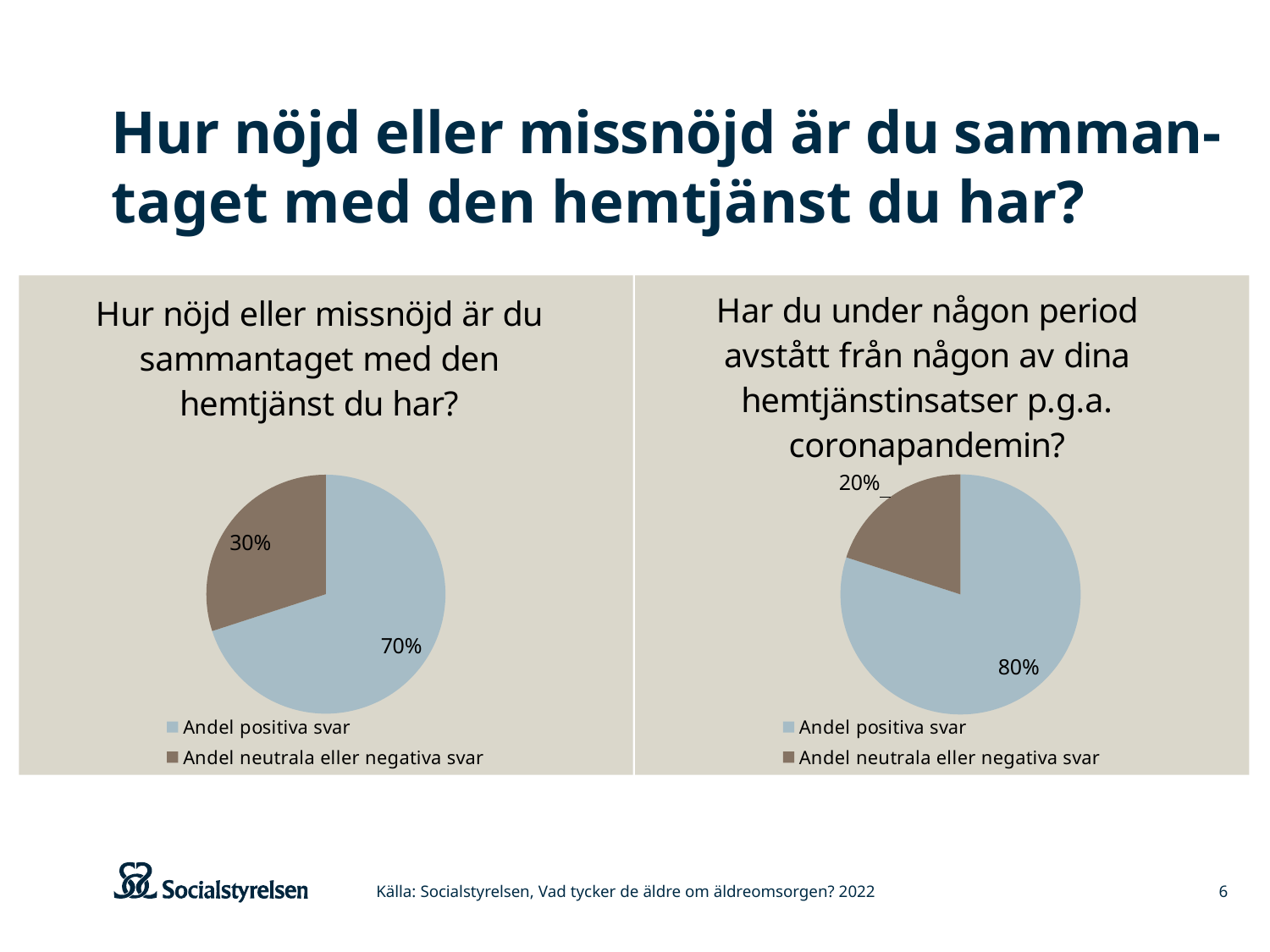
In the left pie chart, which category has the largest slice? Andel positiva svar In the left pie chart, what share is labelled for 'Andel neutrala eller negativa svar'? 30% How many entries does the legend of the left pie chart list? 2 In the right pie chart, what share is labelled for 'Andel neutrala eller negativa svar'? 20% In the right pie chart, which category has the smallest slice? Andel neutrala eller negativa svar In the left pie chart, what share is labelled for 'Andel positiva svar'? 70% Which chart has the larger share of 'Andel positiva svar', the left chart or the right chart? The right chart In the right pie chart, what share is labelled for 'Andel positiva svar'? 80% What is the title of the right pie chart? Har du under någon period avstått från någon av dina hemtjänstinsatser p.g.a. coronapandemin? What type of chart is used on the left side of the slide? Pie chart How many slices does the right pie chart have? 2 In the left pie chart, what is the difference in percentage points between 'Andel positiva svar' and 'Andel neutrala eller negativa svar'? 40 percentage points